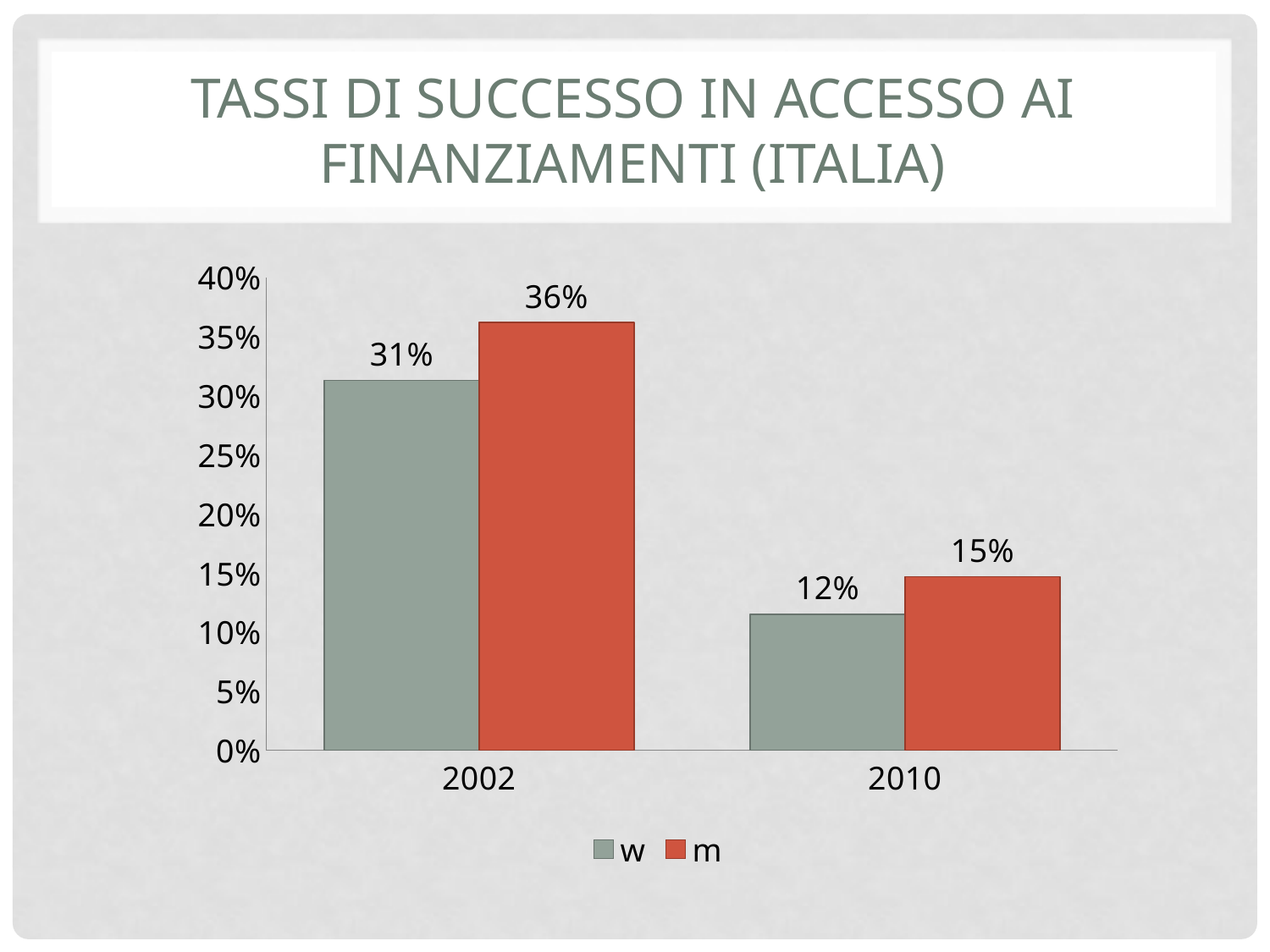
How many series does the legend list? 2 Which is larger, the value for m in 2010 or the value for w in 2002? w in 2002 What is the value for m in 2010? 15% What is the value for m in 2002? 36% What is the value for w in 2002? 31% What is the difference between the w value in 2002 and the w value in 2010? 19% What kind of chart is shown on the slide? bar chart What is the value for w in 2010? 12% Do the values for m rise or fall from 2002 to 2010? fall What is the difference between m and w in 2002? 5% Which year has the lowest value for w? 2010 Which series has the highest value in 2002? m